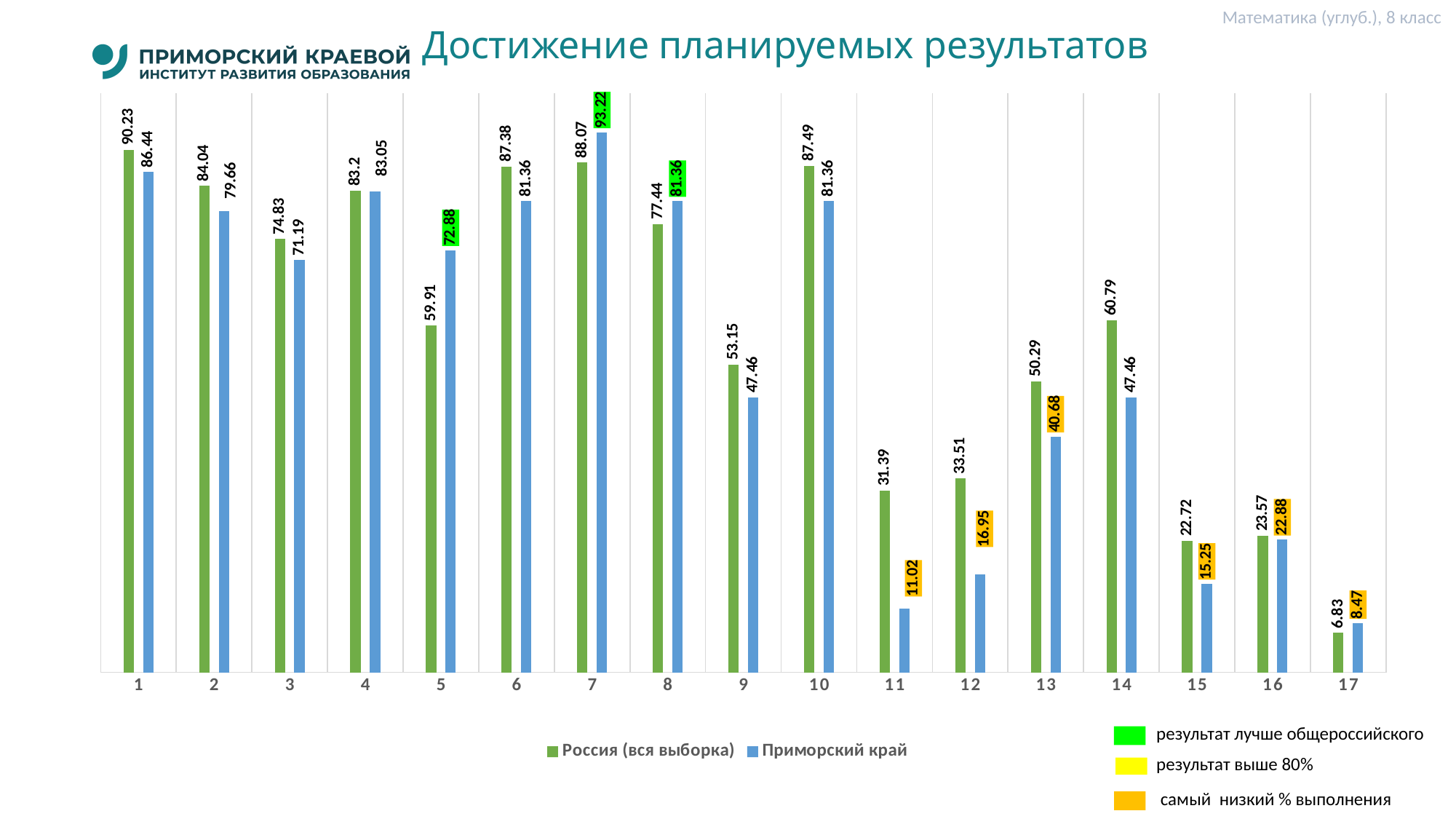
What is the value for Приморский край for task 7? 93.22 What is the difference between Россия (вся выборка) and Приморский край for task 11? 20.37 Which colour represents the series Приморский край in the chart? Blue What is the value for Приморский край for task 13? 40.68 What is the difference between Приморский край and Россия (вся выборка) for task 5? 12.97 For task 9, which series has the larger value: Россия (вся выборка) or Приморский край? Россия (вся выборка) What kind of chart is shown on the slide? Bar chart Which task has the highest value for Приморский край? 7 How many tasks (categories) are shown on the x axis? 17 What is the value for Россия (вся выборка) for task 11? 31.39 How many series does the chart legend list? 2 Which task has the lowest value for Россия (вся выборка)? 17